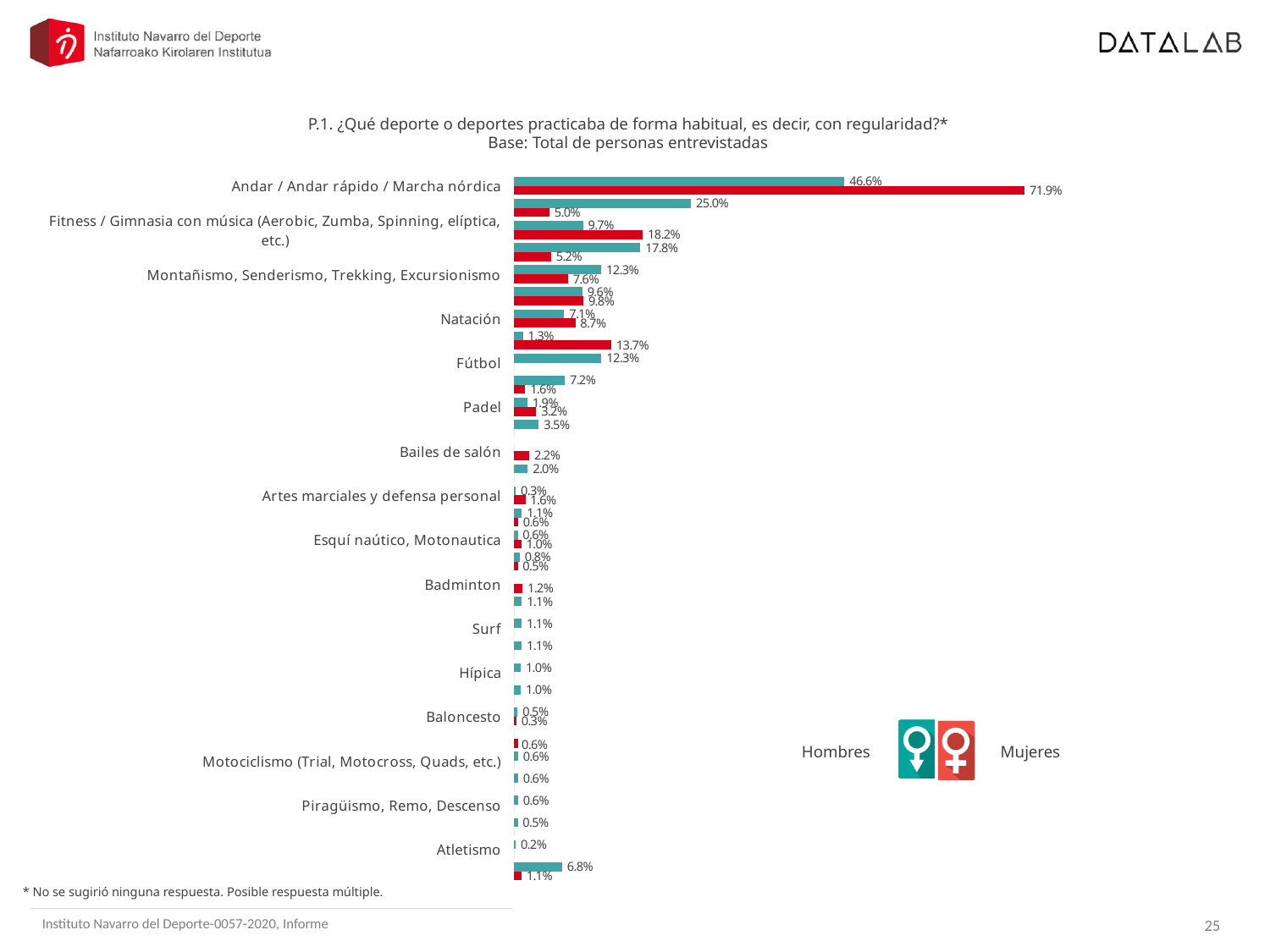
What is the value for Hombres for Andar / Andar rápido / Marcha nórdica? 46.6% What is the difference between the Mujeres and Hombres values for Andar / Andar rápido / Marcha nórdica? 25.3 percentage points What is the base stated under the chart title? Total de personas entrevistadas For Andar / Andar rápido / Marcha nórdica, which is larger, the Hombres value or the Mujeres value? Mujeres What is the value for Mujeres for Andar / Andar rápido / Marcha nórdica? 71.9% Which category has the highest value in the chart? Andar / Andar rápido / Marcha nórdica What is the value for Mujeres for Fitness / Gimnasia con música (Aerobic, Zumba, Spinning, elíptica, etc.)? 18.2% For Natación, which is larger, the Hombres value or the Mujeres value? Mujeres How many series does the legend list? 2 What is the value for Hombres for Montañismo, Senderismo, Trekking, Excursionismo? 12.3% What kind of chart is shown on the slide? bar chart What are the two series named in the legend? Hombres and Mujeres